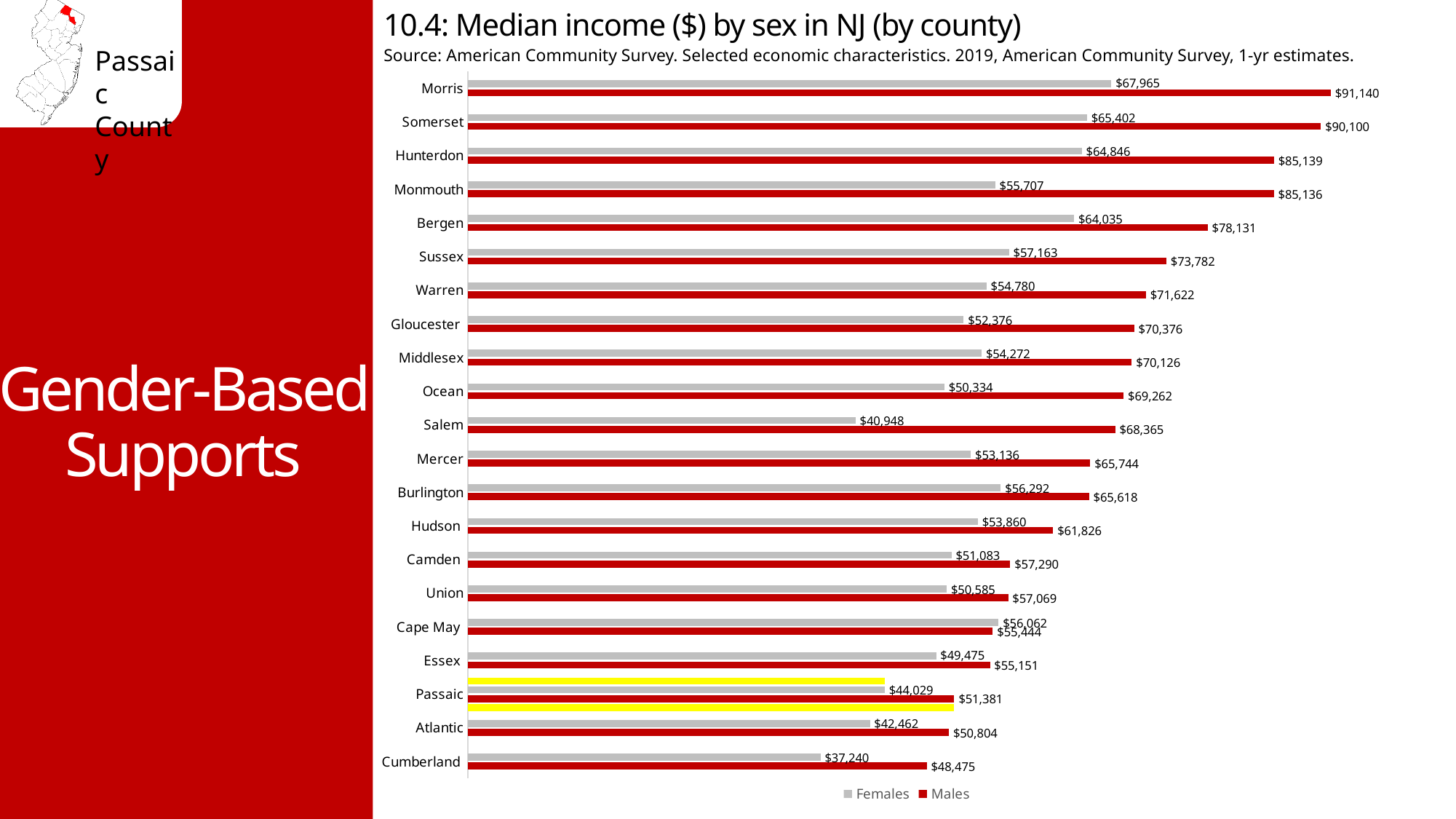
In Cape May County, which is higher: the median income for females or for males? Females Which county has the lowest median income for females? Cumberland What is the difference between male and female median income in Morris County? $23,175 Which is higher: the female median income in Monmouth County or in Bergen County? Bergen County What is the median income for males in Passaic County? $51,381 Which county has the highest median income for males? Morris How many series does the legend list? 2 What is the median income for females in Salem County? $40,948 What type of chart is shown on the slide? Bar chart What is the difference between male and female median income in Passaic County? $7,352 What is the median income for females in Morris County? $67,965 How many counties are shown in the chart? 21